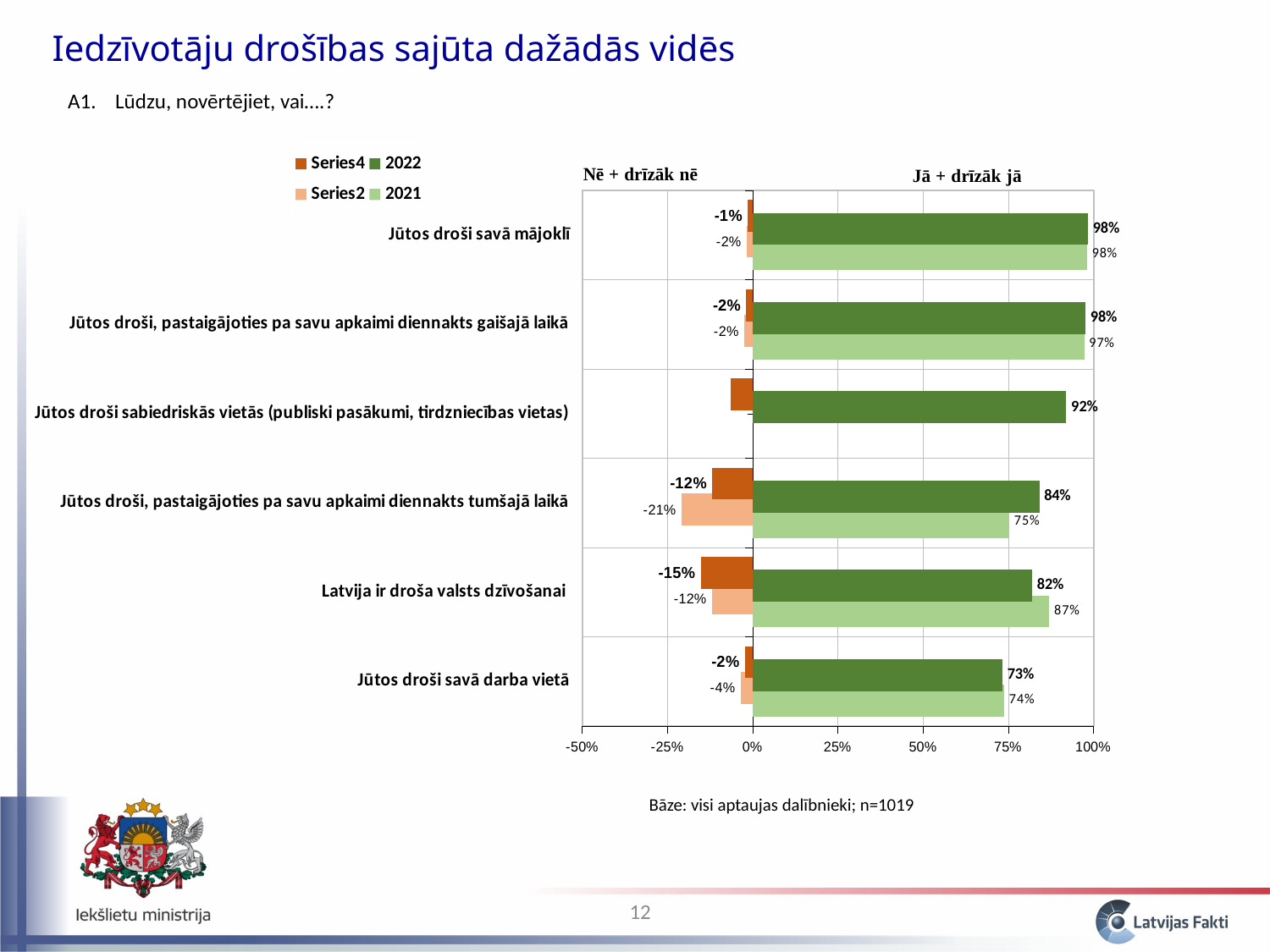
What is the 2021 "Jā + drīzāk jā" value for "Latvija ir droša valsts dzīvošanai"? 87% How many series does the legend list? 4 What is the title of the slide? Iedzīvotāju drošības sajūta dažādās vidēs What is the 2021 "Nē + drīzāk nē" value for "Jūtos droši, pastaigājoties pa savu apkaimi diennakts tumšajā laikā"? -21% What kind of chart is shown on the slide? Bar chart Which category has the lowest 2022 "Jā + drīzāk jā" value? Jūtos droši savā darba vietā How many categories are shown on the chart? 6 What is the 2022 "Jā + drīzāk jā" value for "Jūtos droši savā darba vietā"? 73% What is the 2022 "Jā + drīzāk jā" value for "Jūtos droši sabiedriskās vietās (publiski pasākumi, tirdzniecības vietas)"? 92% Which category has the highest 2021 "Jā + drīzāk jā" value? Jūtos droši savā mājoklī For "Latvija ir droša valsts dzīvošanai", which year has the larger "Jā + drīzāk jā" value, 2022 or 2021? 2021 By how many percentage points does the 2022 "Jā + drīzāk jā" value exceed the 2021 value for "Jūtos droši, pastaigājoties pa savu apkaimi diennakts tumšajā laikā"? 9 percentage points